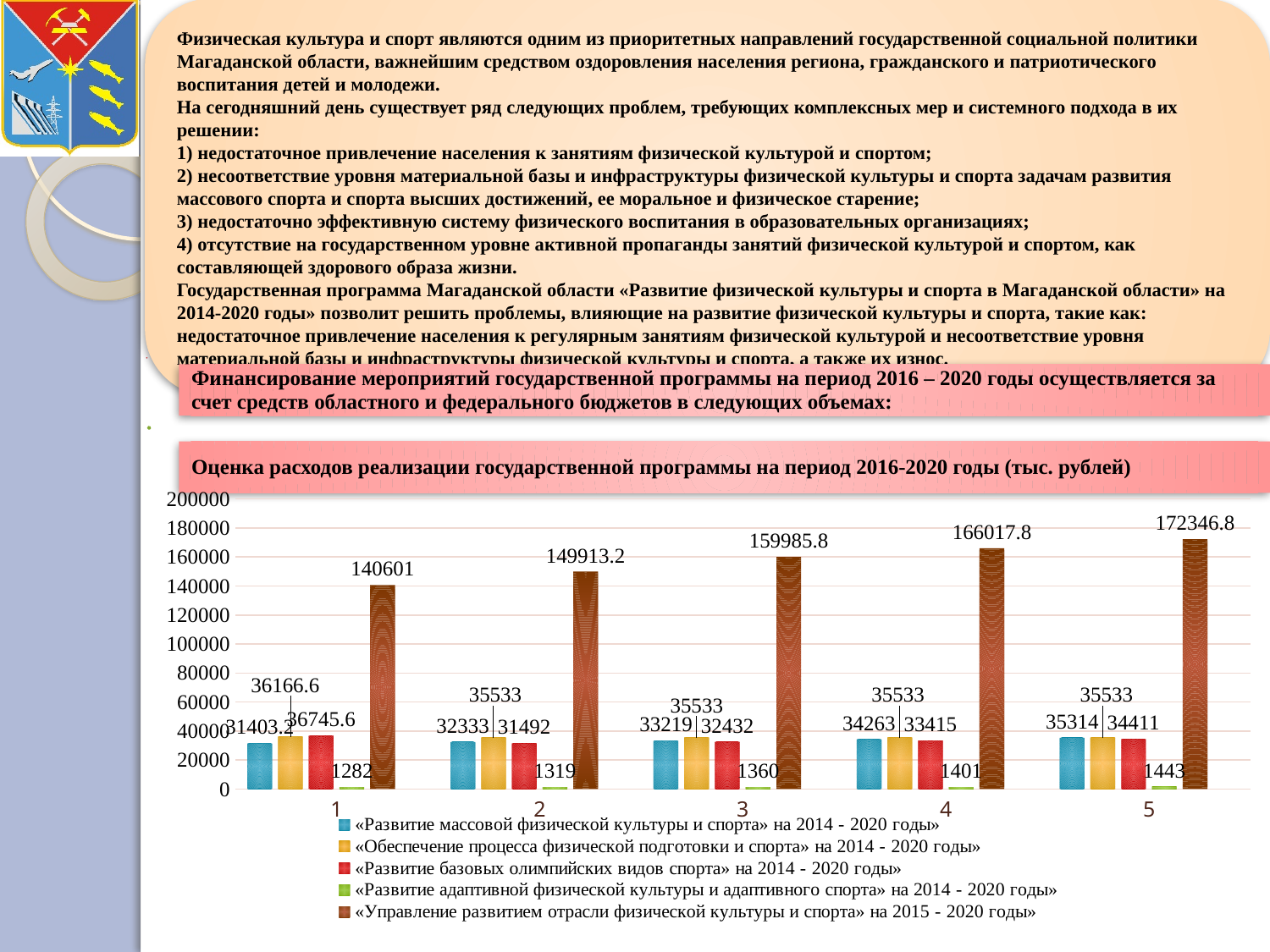
How many categories are shown along the x axis of the chart? 5 Which is larger for category 2: the value of «Развитие массовой физической культуры и спорта» на 2014 - 2020 годы or the value of «Развитие базовых олимпийских видов спорта» на 2014 - 2020 годы? «Развитие массовой физической культуры и спорта» на 2014 - 2020 годы What is the title of the chart? Оценка расходов реализации государственной программы на период 2016-2020 годы (тыс. рублей) For which category is the value of the series «Развитие адаптивной физической культуры и адаптивного спорта» на 2014 - 2020 годы the lowest? 1 What is the difference between the values of the series «Управление развитием отрасли физической культуры и спорта» на 2015 - 2020 годы for category 5 and category 4? 6329 What kind of chart is shown on the slide? bar chart What is the value of the series «Управление развитием отрасли физической культуры и спорта» на 2015 - 2020 годы for category 1? 140601 For which category is the value of the series «Управление развитием отрасли физической культуры и спорта» на 2015 - 2020 годы the highest? 5 What is the value of the series «Развитие адаптивной физической культуры и адаптивного спорта» на 2014 - 2020 годы for category 5? 1443 How many series does the chart legend list? 5 What is the value of the series «Развитие массовой физической культуры и спорта» на 2014 - 2020 годы for category 3? 33219 Do the values of the series «Управление развитием отрасли физической культуры и спорта» на 2015 - 2020 годы rise or fall from category 1 to category 5? rise